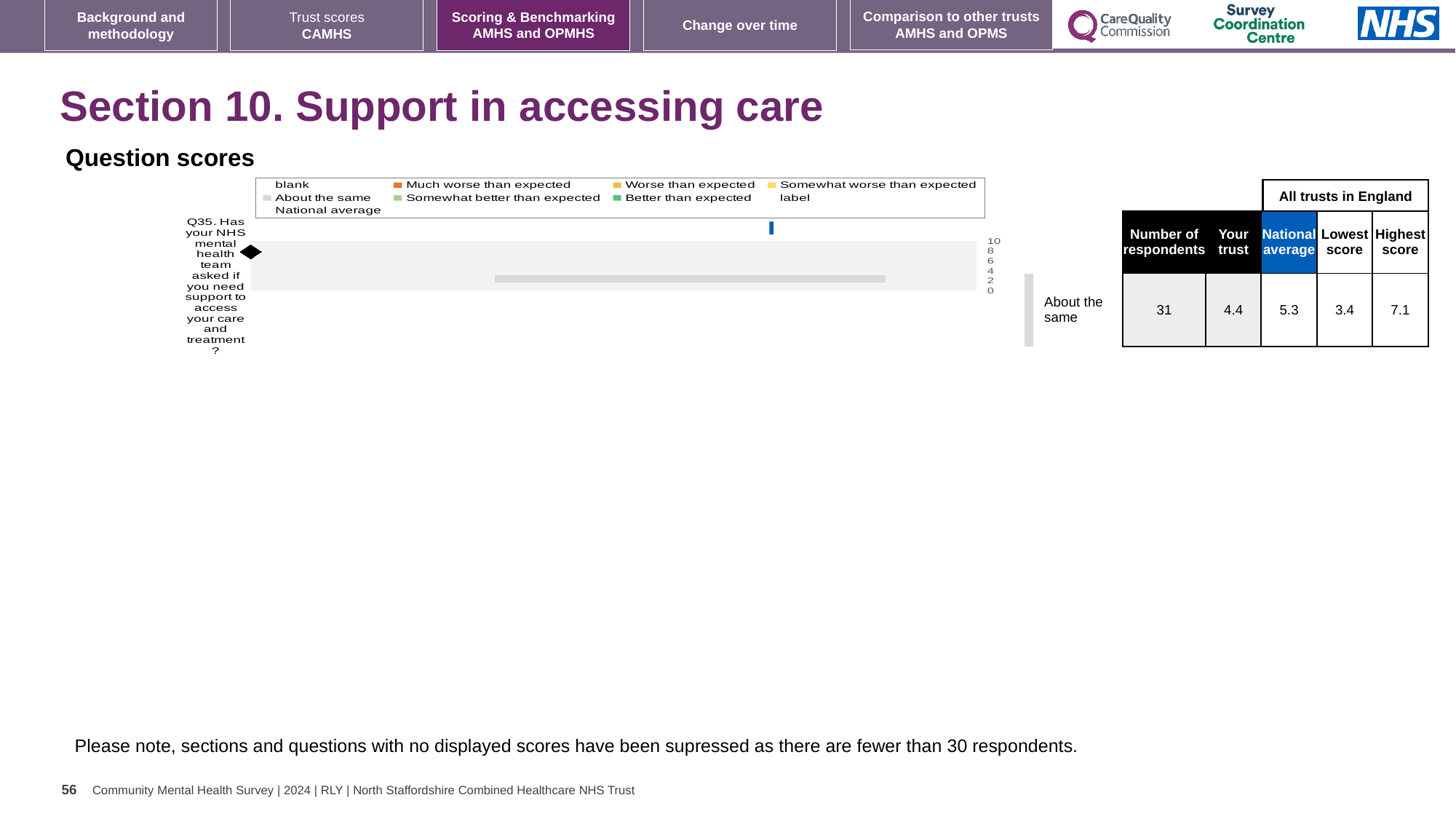
How many entries does the legend of the Question scores chart list? 9 What is the difference between the highest and lowest scores for Q35 across all trusts in England? 3.7 What is the national average score for Q35? 5.3 What is the highest score among all trusts in England for Q35? 7.1 Which benchmark category is shown for Q35 in the Question scores chart? About the same What is the lowest score among all trusts in England for Q35? 3.4 How many questions are plotted in the Question scores chart? 1 What is the number of respondents for Q35? 31 What is the 'Your trust' score for Q35? 4.4 Which is larger for Q35, the 'Your trust' score or the national average? National average What is the maximum value shown on the score axis of the Question scores chart? 10 What kind of chart is used to show the Q35 question score? bar chart